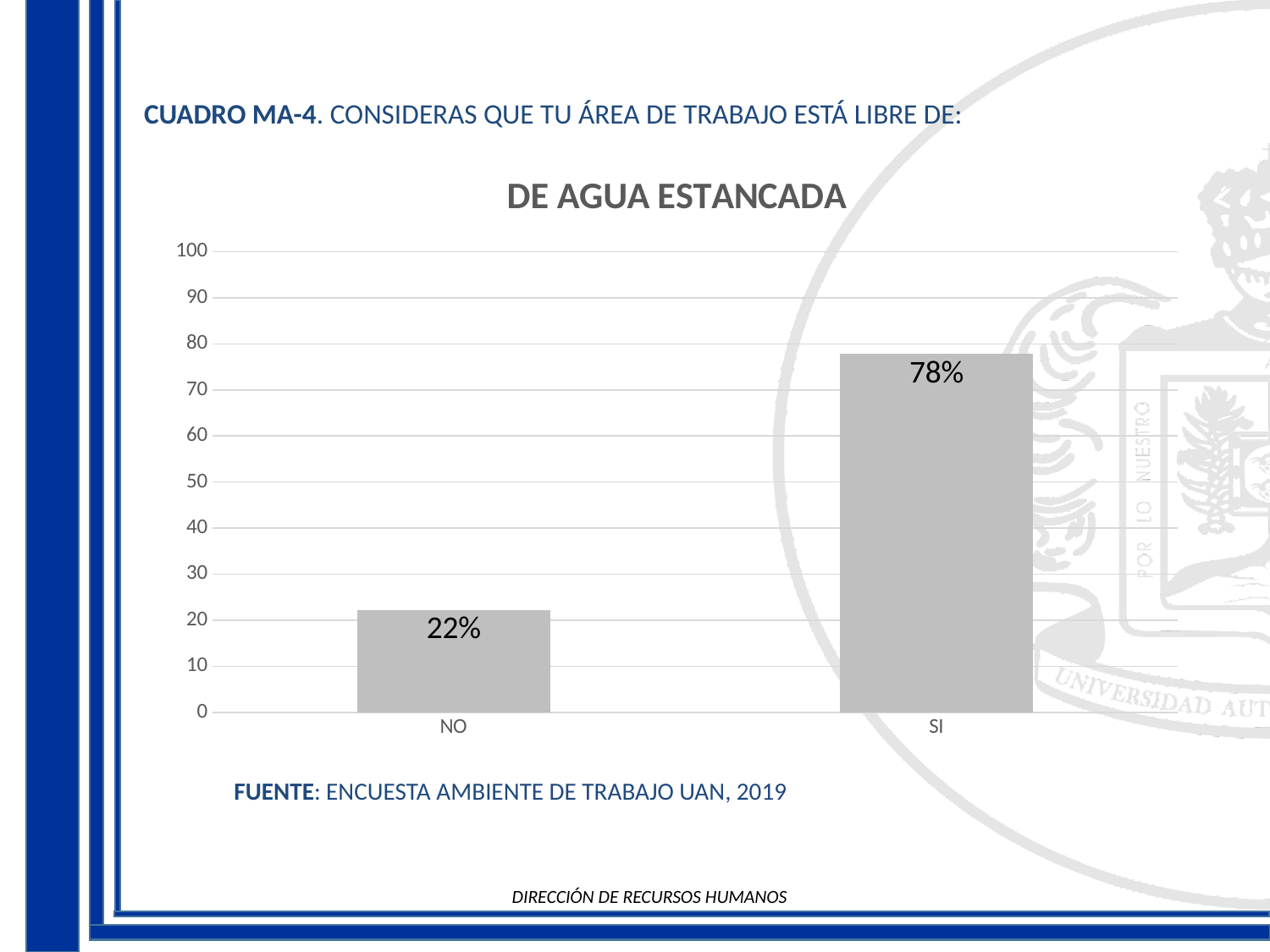
Which category has the highest value? SI Is the value for NO greater or less than 30? less Is the value for SI greater or less than 70? greater What is the difference between the values for SI and NO? 56% How many categories are shown on the x axis? 2 Which category has the lowest value? NO What is the title of the chart? DE AGUA ESTANCADA What is the value for SI? 78% Which is larger, the value for NO or the value for SI? SI What kind of chart is shown on the slide? bar chart What is the maximum value shown on the y axis? 100 What is the value for NO? 22%